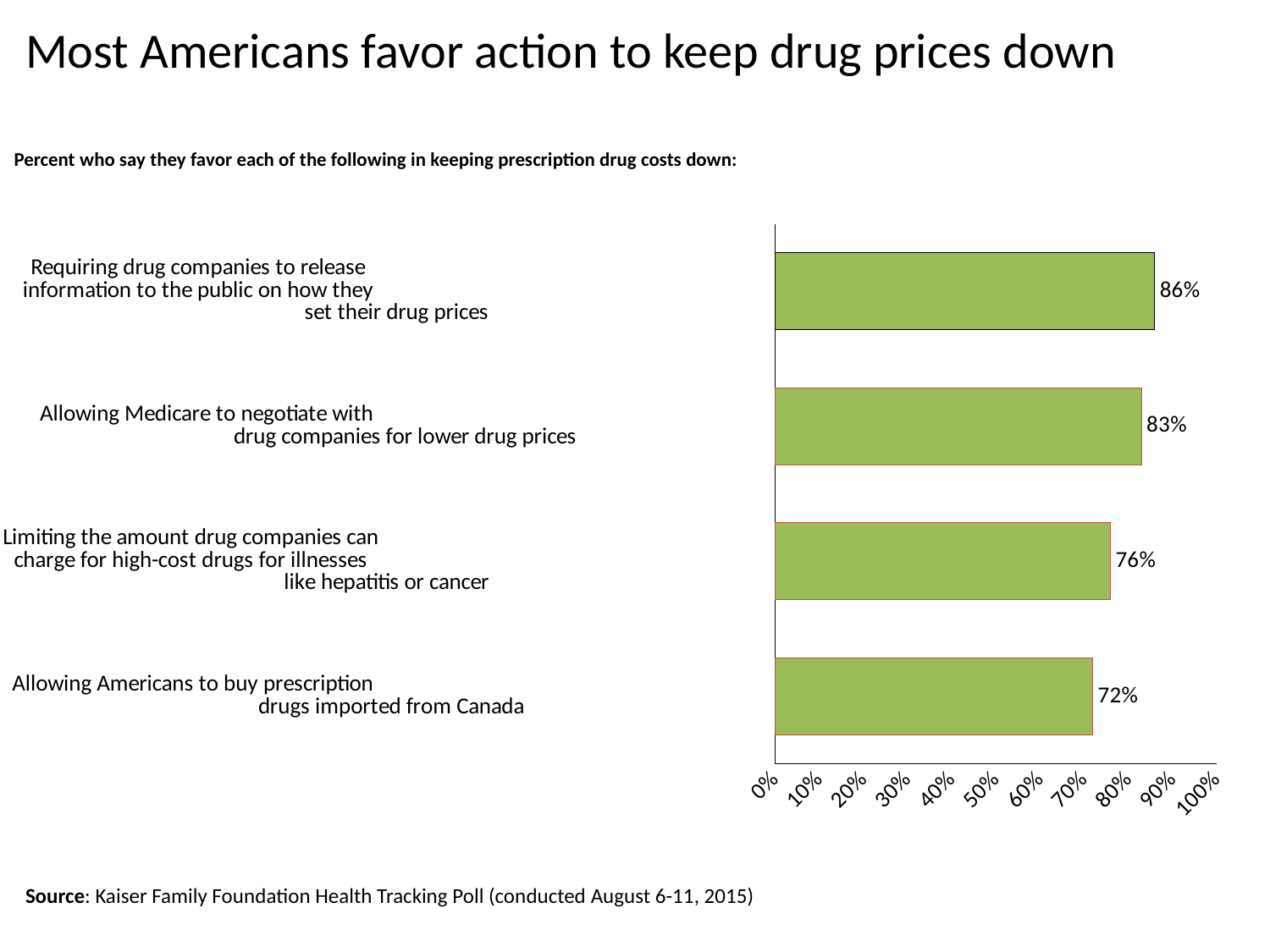
Is the value for allowing Americans to buy prescription drugs imported from Canada greater or less than 80%? less Which action has the highest percent in favor? Requiring drug companies to release information to the public on how they set their drug prices Which action has the lowest percent in favor? Allowing Americans to buy prescription drugs imported from Canada What kind of chart is shown on the slide? Bar chart What percent favor limiting the amount drug companies can charge for high-cost drugs for illnesses like hepatitis or cancer? 76% What percent favor allowing Medicare to negotiate with drug companies for lower drug prices? 83% What percent favor allowing Americans to buy prescription drugs imported from Canada? 72% Which has a larger percent in favor: allowing Medicare to negotiate with drug companies or allowing Americans to buy drugs imported from Canada? Allowing Medicare to negotiate with drug companies for lower drug prices What is the difference in percentage points between allowing Medicare to negotiate and limiting the amount drug companies can charge for high-cost drugs? 7 What percent favor requiring drug companies to release information to the public on how they set their drug prices? 86% What is the difference in percentage points between the highest and lowest bars? 14 How many actions (bars) are shown in the chart? 4